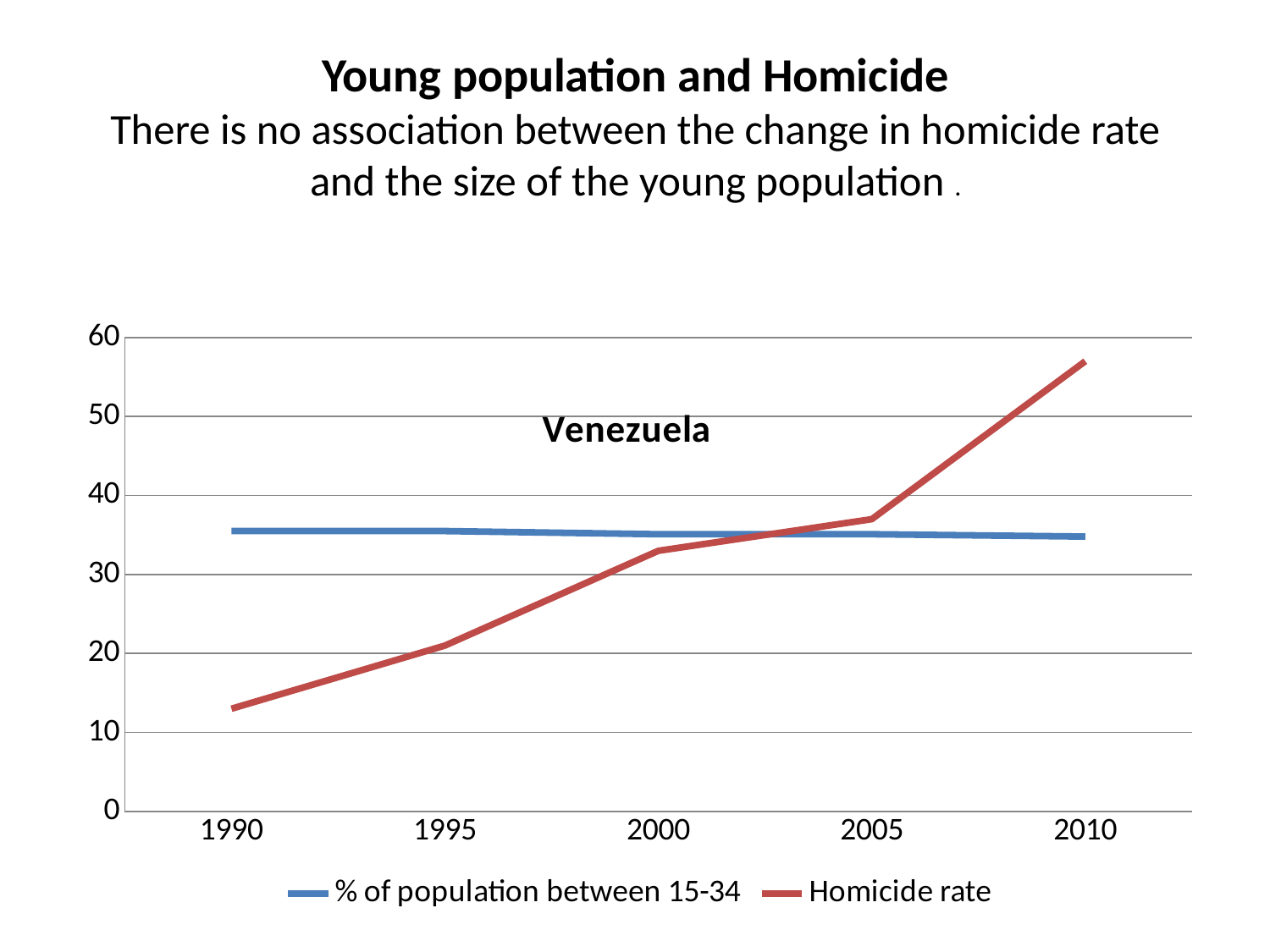
In 1995, which is larger: the Homicide rate or the % of population between 15-34? % of population between 15-34 Does the Homicide rate rise or fall from 1990 to 2010? rise How many series does the legend list? 2 Which country is named in the chart title? Venezuela What kind of chart is shown on the slide? line chart Is the Homicide rate in 2010 greater or less than 50? greater How many years are shown on the x axis? 5 Is the Homicide rate in 1990 greater or less than 20? less In 2010, which is larger: the Homicide rate or the % of population between 15-34? Homicide rate In which year is the Homicide rate lowest? 1990 Is the Homicide rate in 1995 greater or less than 30? less In which year is the Homicide rate highest? 2010